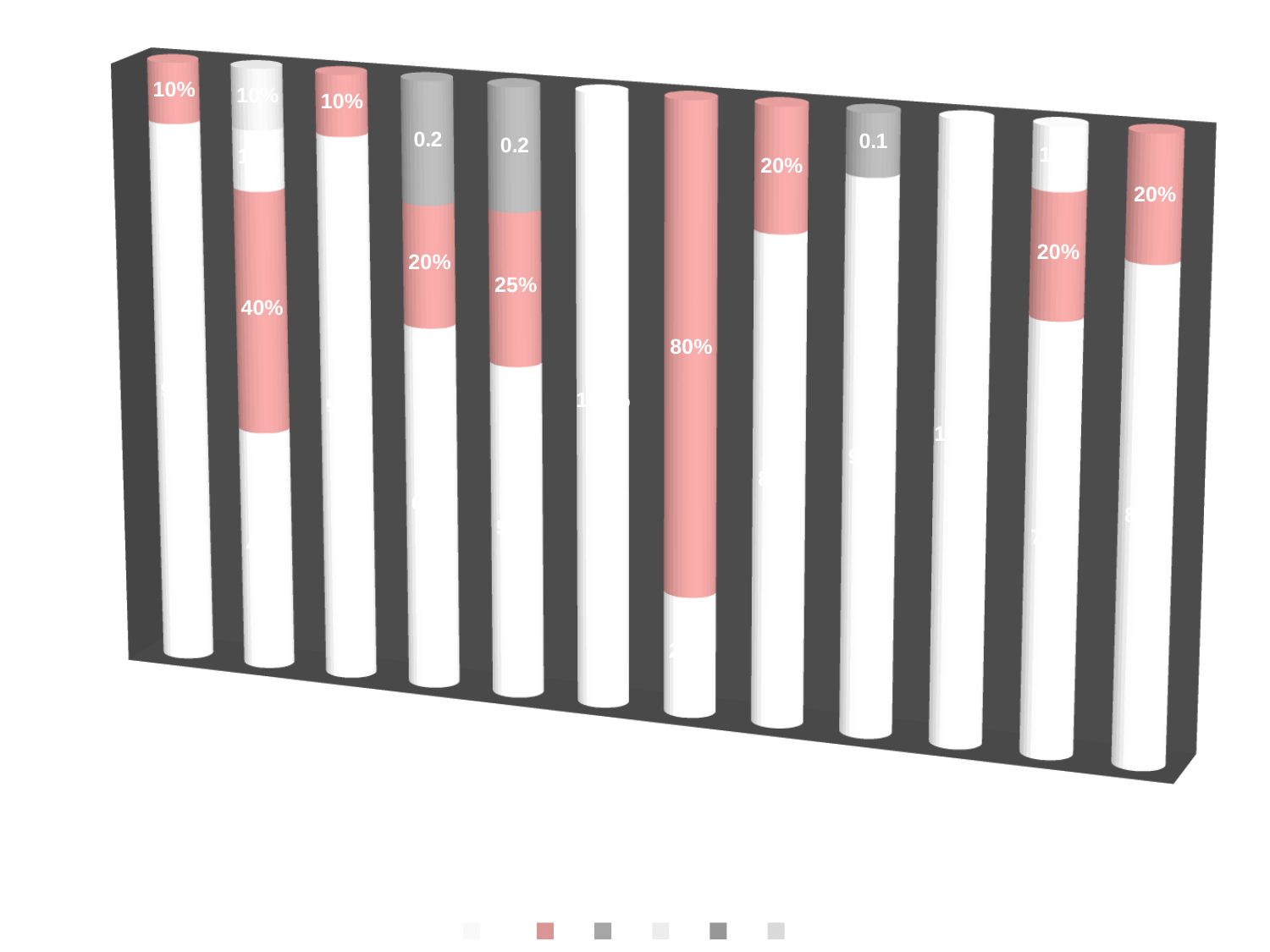
What is the value printed on the pink segment of the fifth bar from the left? 25% What is the value printed on the grey segment at the top of the fourth bar from the left? 0.2 What is the value printed on the grey segment at the top of the ninth bar from the left? 0.1 Which bar has the largest pink segment? The seventh bar from the left What is the value printed on the pink segment of the seventh bar from the left? 80% How many series does the legend list? 6 What is the difference between the pink segment of the seventh bar from the left and the pink segment of the eighth bar from the left? 60% What kind of chart is shown on the slide? Stacked bar chart Which is larger, the pink segment of the second bar from the left or the pink segment of the fifth bar from the left? The second bar (40%) What is the value printed on the pink segment of the second bar from the left? 40% How many bars are plotted in the chart? 12 What is the value printed on the pink segment of the first bar from the left? 10%